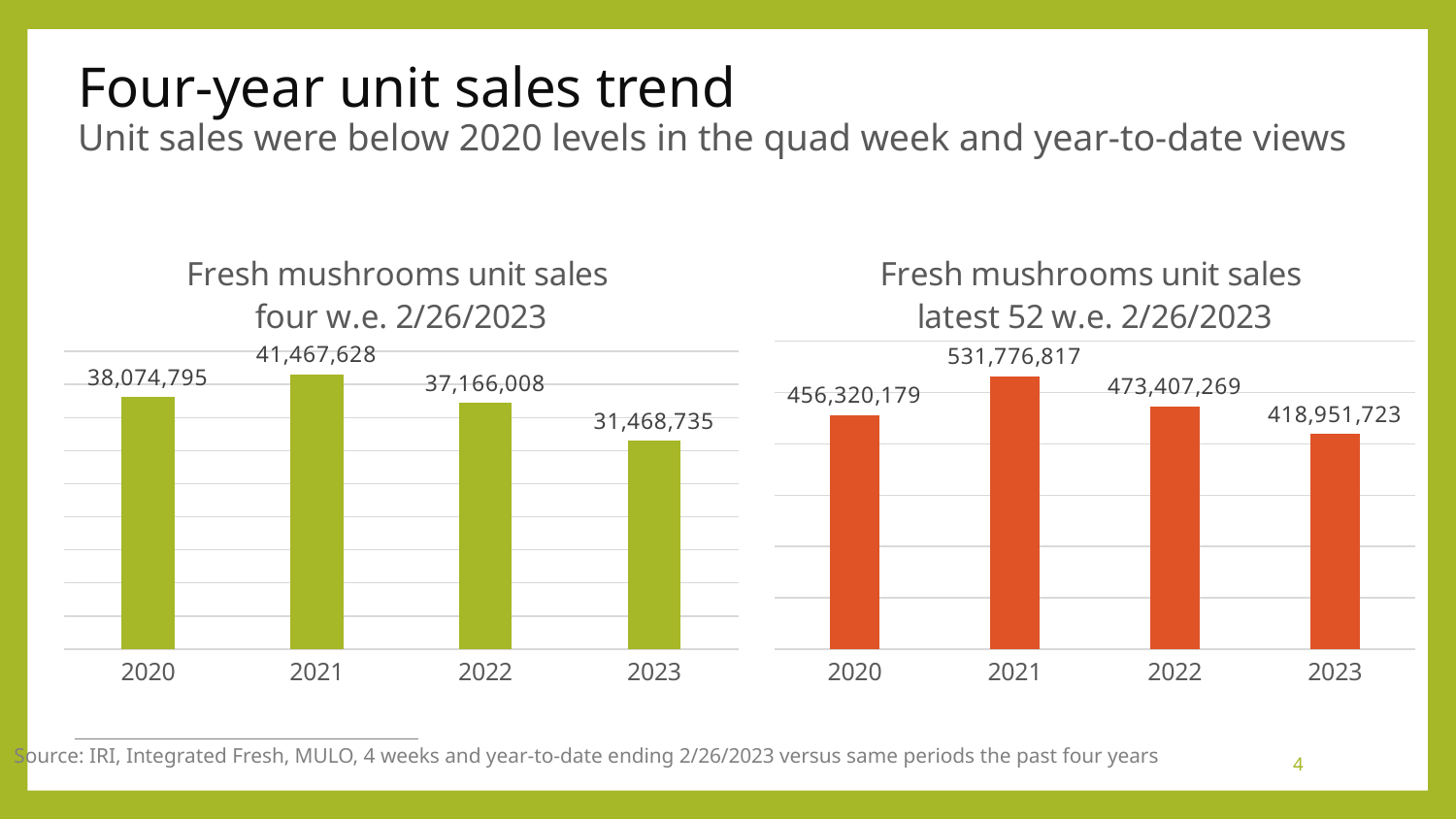
In the chart titled 'Fresh mushrooms unit sales latest 52 w.e. 2/26/2023', what is the value for 2023? 418,951,723 What colour are the bars in the left chart (four w.e. 2/26/2023)? Green In the left chart (four w.e. 2/26/2023), which year has the lowest unit sales? 2023 In the right chart (latest 52 w.e. 2/26/2023), which is larger, the value for 2020 or the value for 2022? 2022 What kind of chart is the right chart (latest 52 w.e. 2/26/2023)? Bar chart How many years are shown on the x axis of the left chart (four w.e. 2/26/2023)? 4 In the right chart (latest 52 w.e. 2/26/2023), which year has the highest unit sales? 2021 In the left chart (four w.e. 2/26/2023), which is larger, the value for 2020 or the value for 2023? 2020 In the right chart (latest 52 w.e. 2/26/2023), what is the difference between the 2021 and 2023 values? 112,825,094 In the right chart (latest 52 w.e. 2/26/2023), do the values rise or fall from 2021 to 2023? Fall In the left chart (four w.e. 2/26/2023), what is the difference between the 2021 and 2020 values? 3,392,833 In the chart titled 'Fresh mushrooms unit sales four w.e. 2/26/2023', what is the value for 2021? 41,467,628